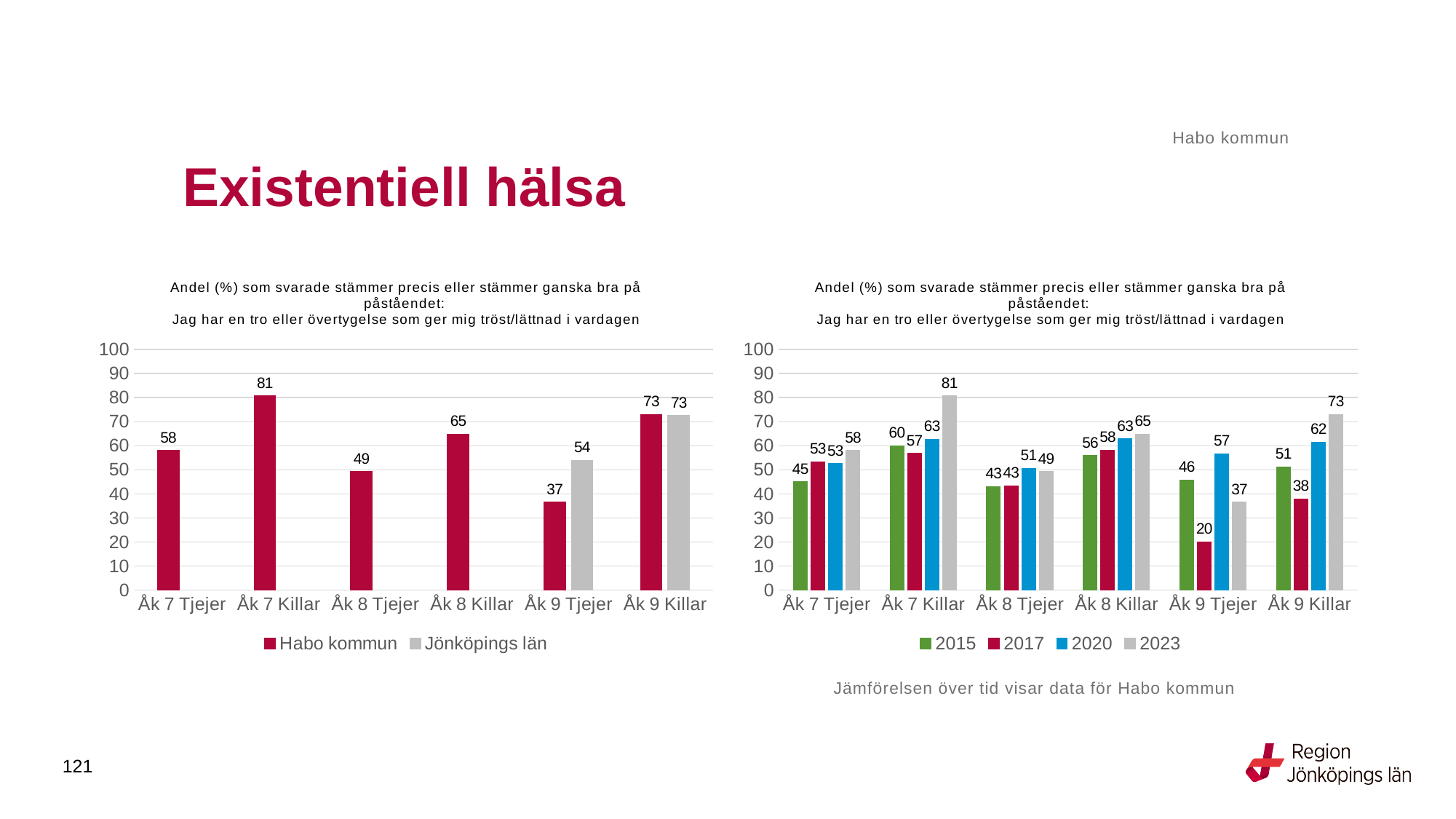
In the left chart, what type of chart is shown? Bar chart In the left chart, how many series does the legend list? 2 In the left chart, what is the value for Habo kommun for Åk 7 Killar? 81 In the right chart, how many categories are shown on the x axis? 6 In the left chart, what is the value for Jönköpings län for Åk 9 Tjejer? 54 In the right chart, what is the 2017 value for Åk 9 Tjejer? 20 In the left chart, what is the difference between the Habo kommun values for Åk 7 Killar and Åk 7 Tjejer? 23 In the right chart, what is the 2020 value for Åk 8 Tjejer? 51 In the right chart, how many series does the legend list? 4 In the left chart, which category has the lowest Habo kommun value? Åk 9 Tjejer In the right chart, which is larger for Åk 9 Killar: the 2015 value or the 2017 value? 2015 In the right chart, which year has the highest value for Åk 7 Killar? 2023